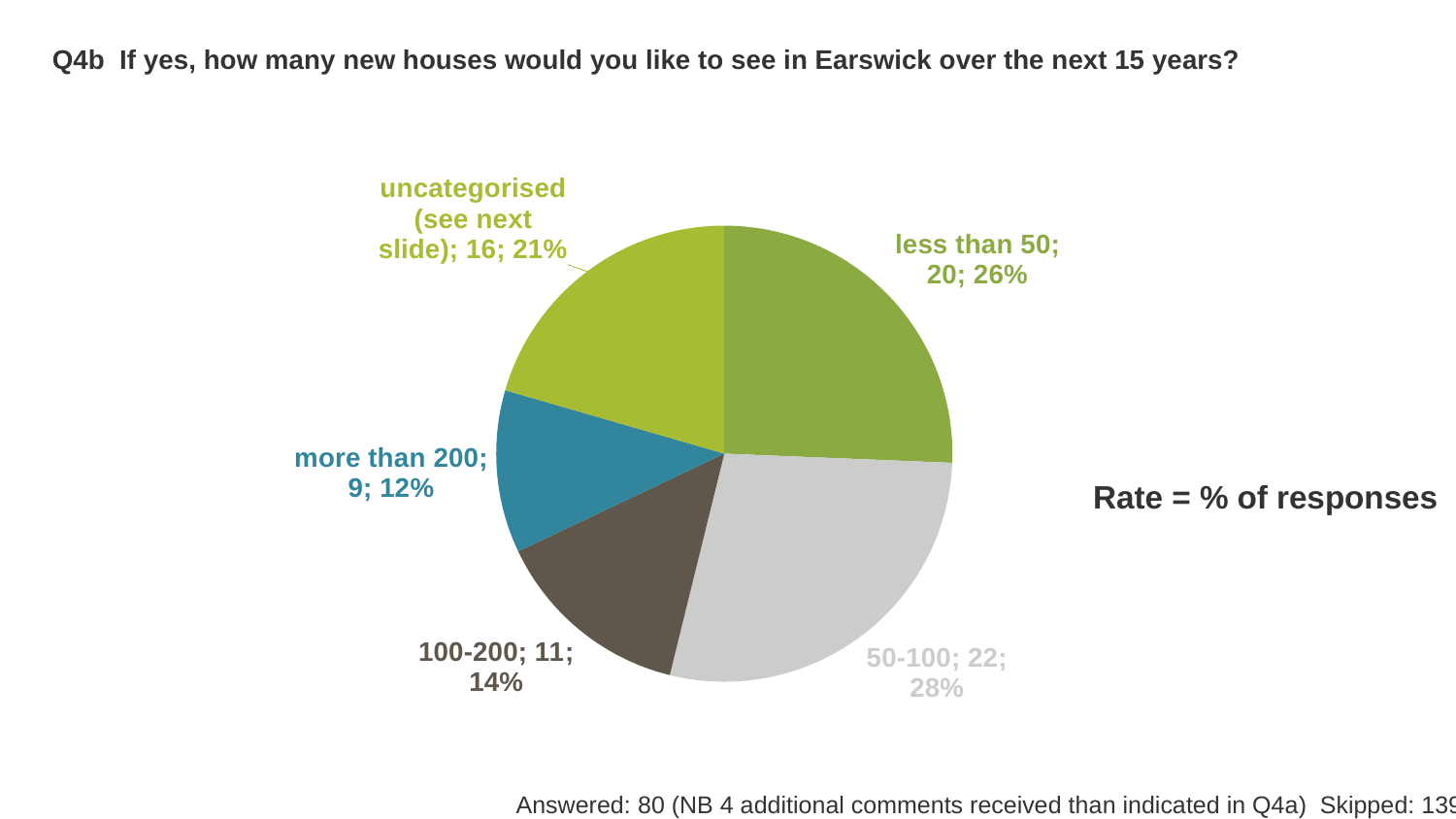
Which category has the largest number of responses? 50-100 Which has more responses, 'uncategorised (see next slide)' or '100-200'? uncategorised (see next slide) What kind of chart is shown on the slide? pie chart What does the text to the right of the pie chart say 'Rate' equals? % of responses Which category has the smallest number of responses? more than 200 How many responses are in the 'more than 200' category? 9 How many slices does the pie chart have? 5 How many responses are in the '50-100' category? 22 What is the total number of responses across all slices of the pie chart? 78 What percentage of responses does the '100-200' slice represent? 14% What is the difference in responses between '50-100' and 'less than 50'? 2 What percentage of responses does the 'less than 50' slice represent? 26%